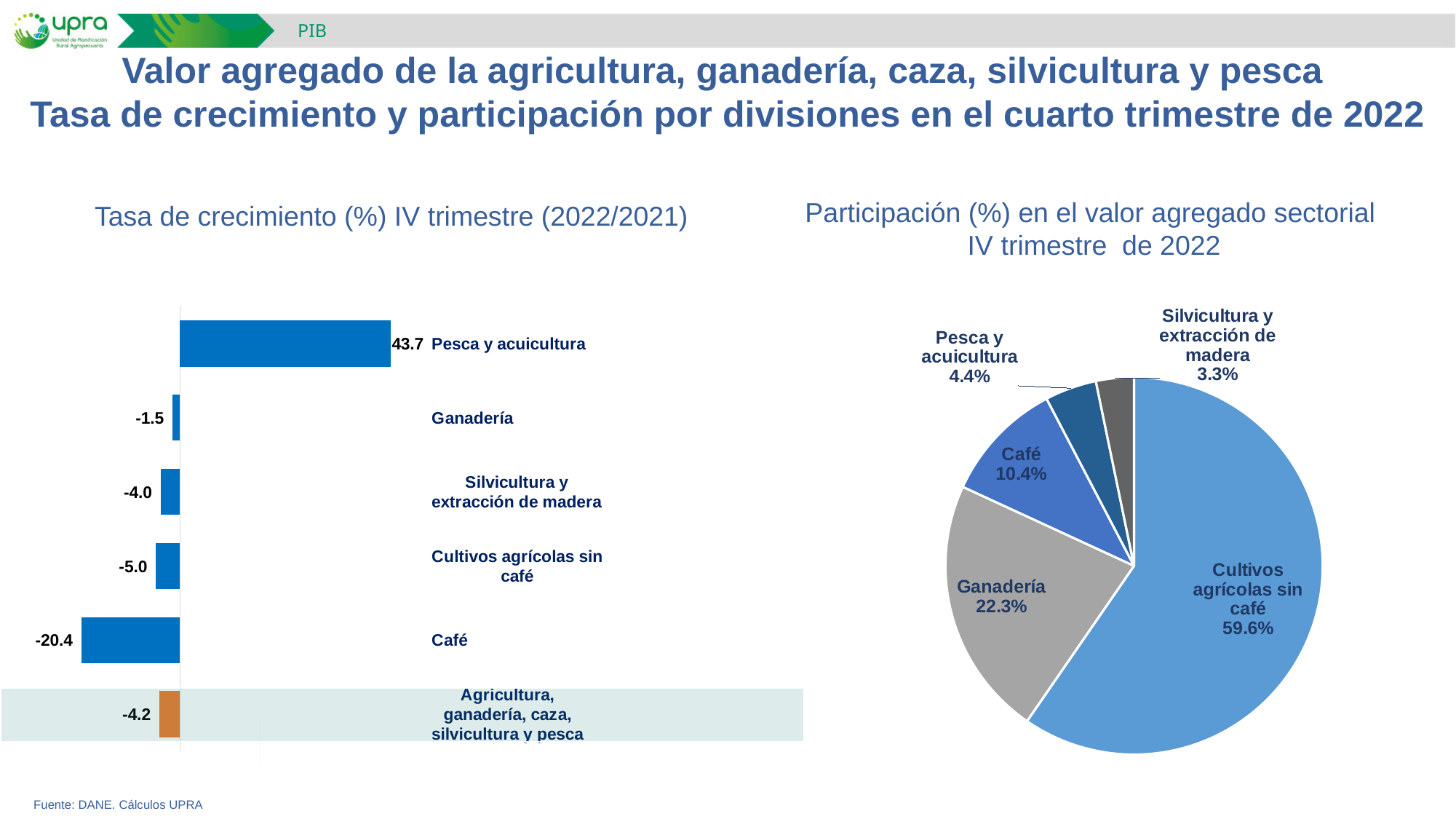
In the 'Participación (%) en el valor agregado sectorial IV trimestre de 2022' chart, which slice is the largest? Cultivos agrícolas sin café In the 'Tasa de crecimiento (%) IV trimestre (2022/2021)' chart, what is the value for Agricultura, ganadería, caza, silvicultura y pesca? -4.2 In the 'Tasa de crecimiento (%) IV trimestre (2022/2021)' chart, how many categories are shown? 6 What kind of chart is the 'Participación (%) en el valor agregado sectorial IV trimestre de 2022' chart? Pie chart In the 'Tasa de crecimiento (%) IV trimestre (2022/2021)' chart, what is the value for Pesca y acuicultura? 43.7 In the 'Tasa de crecimiento (%) IV trimestre (2022/2021)' chart, what is the difference between the values for Cultivos agrícolas sin café and Silvicultura y extracción de madera? 1.0 In the 'Tasa de crecimiento (%) IV trimestre (2022/2021)' chart, what is the value for Café? -20.4 In the 'Participación (%) en el valor agregado sectorial IV trimestre de 2022' chart, which slice is the smallest? Silvicultura y extracción de madera What kind of chart is the 'Tasa de crecimiento (%) IV trimestre (2022/2021)' chart? Bar chart In the 'Tasa de crecimiento (%) IV trimestre (2022/2021)' chart, which category has the lowest value? Café In the 'Participación (%) en el valor agregado sectorial IV trimestre de 2022' chart, what is the share for Ganadería? 22.3% In the 'Tasa de crecimiento (%) IV trimestre (2022/2021)' chart, which category has the highest value? Pesca y acuicultura